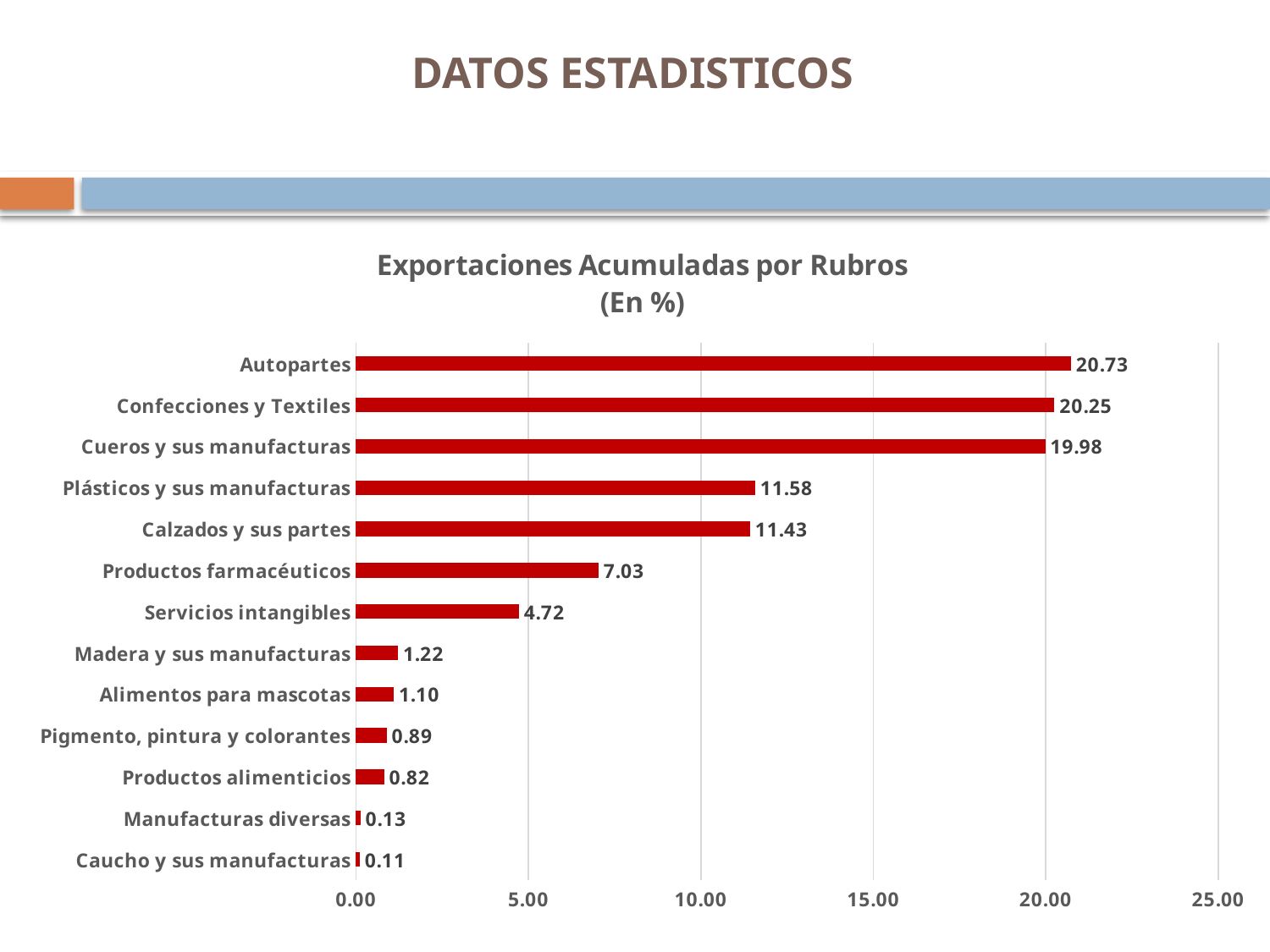
How many categories are shown in the chart? 13 What is the value for Servicios intangibles? 4.72 Is the value for Plásticos y sus manufacturas greater or less than 10.00? greater What is the difference between Plásticos y sus manufacturas and Productos farmacéuticos? 4.55 What is the value for Autopartes? 20.73 Which category has the lowest value? Caucho y sus manufacturas What is the difference between Autopartes and Confecciones y Textiles? 0.48 What is the value for Productos farmacéuticos? 7.03 What kind of chart is shown on the slide? Bar chart Which category has the highest value? Autopartes What is the title of the chart? Exportaciones Acumuladas por Rubros (En %) Which is larger, Cueros y sus manufacturas or Calzados y sus partes? Cueros y sus manufacturas